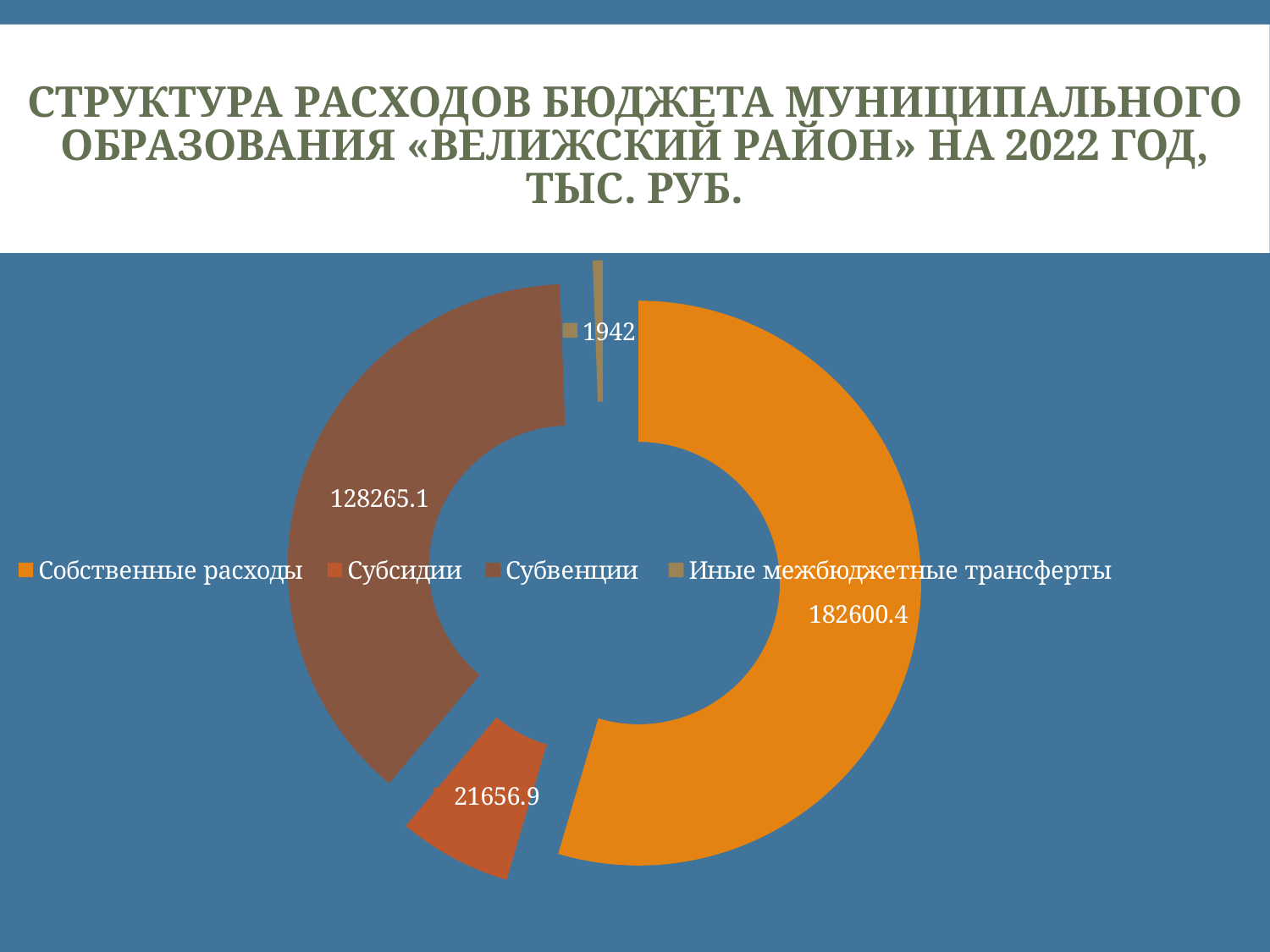
What is the value for Собственные расходы? 182600.4 Which is larger, Субвенции or Субсидии? Субвенции Which category has the highest value? Собственные расходы What is the difference between Собственные расходы and Субвенции? 54335.3 What is the value for Субсидии? 21656.9 What is the difference between Субсидии and Иные межбюджетные трансферты? 19714.9 What colour is the Собственные расходы segment? orange What is the value for Иные межбюджетные трансферты? 1942 What kind of chart is shown on the slide? doughnut chart How many categories does the chart show? 4 What is the value for Субвенции? 128265.1 Which category has the lowest value? Иные межбюджетные трансферты